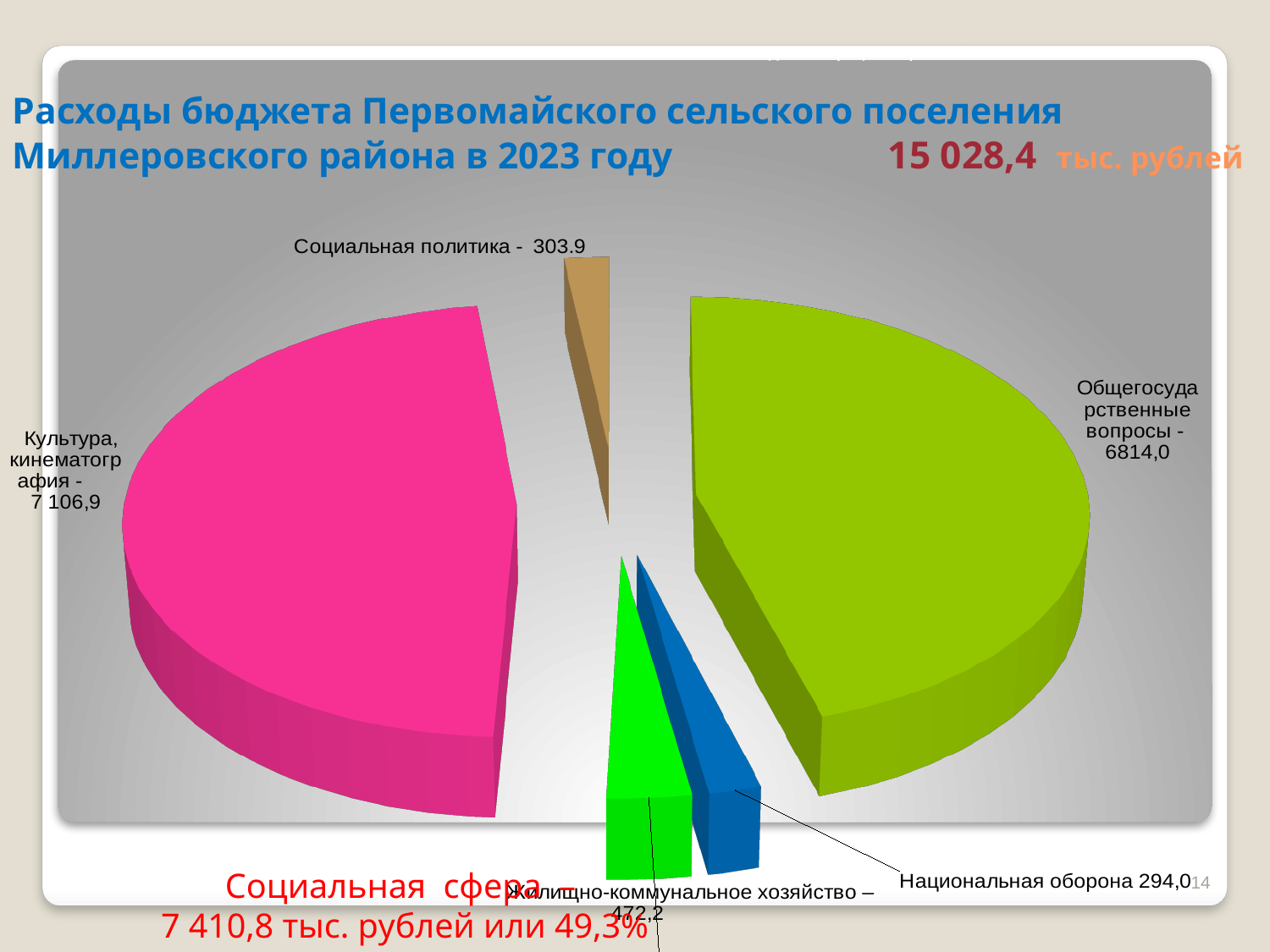
What is the value for Культура, кинематография? 7 106,9 Which category has the largest slice of the pie? Культура, кинематография What is the value for Национальная оборона? 294,0 What is the difference between the values for Культура, кинематография and Общегосударственные вопросы? 292,9 What is the value for Общегосударственные вопросы? 6814,0 What total budget expenditure amount (in тыс. рублей) is shown in the slide title? 15 028,4 What is the value for Социальная политика? 303.9 What kind of chart is shown on the slide? Pie chart What is the value for Жилищно-коммунальное хозяйство? 472,2 Which is larger: Общегосударственные вопросы or Жилищно-коммунальное хозяйство? Общегосударственные вопросы Which category has the smallest slice of the pie? Национальная оборона How many slices does the pie chart have? 5